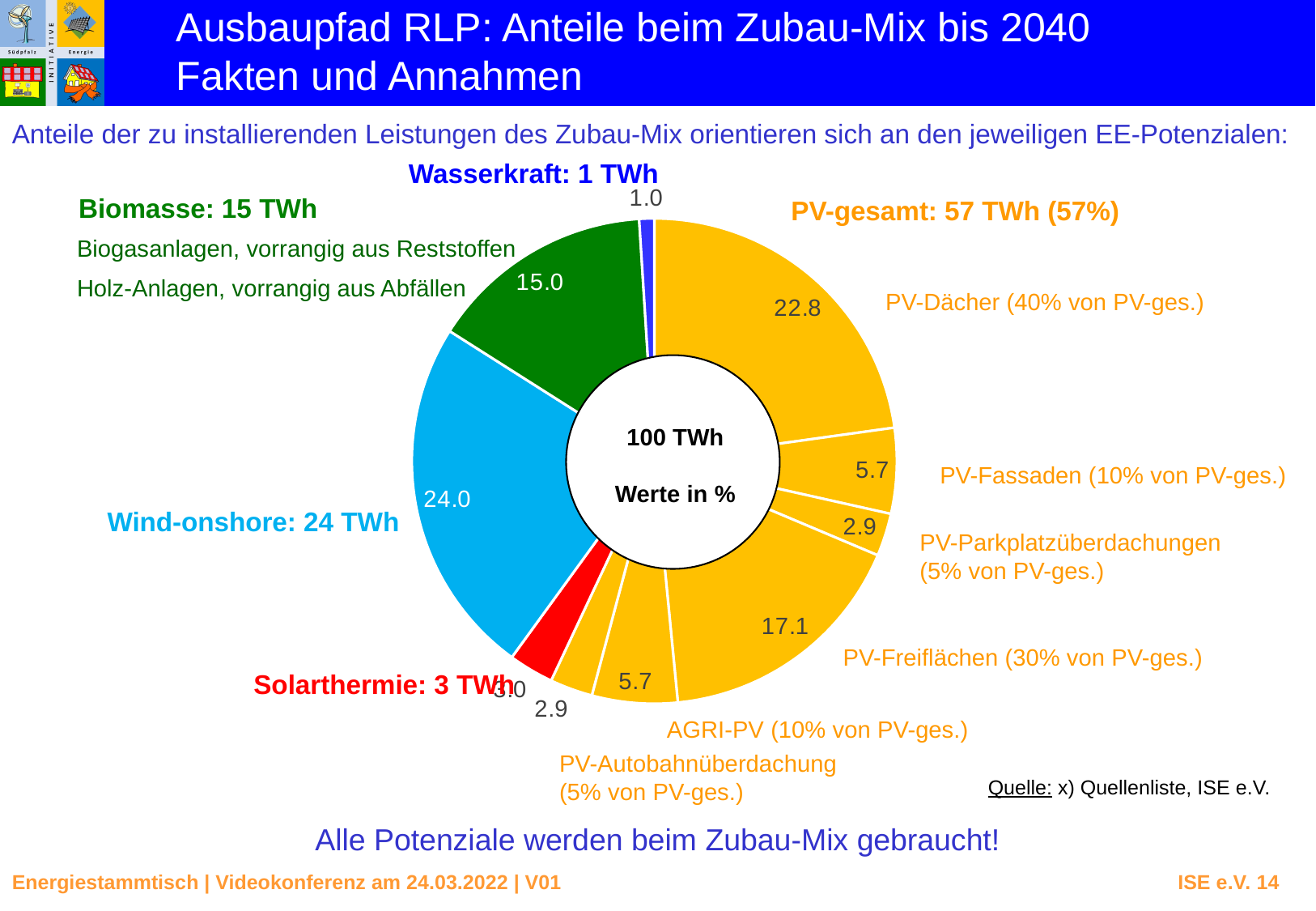
What is the value shown for the PV-Freiflächen segment? 17.1 Which segment has the smallest value in the chart? Wasserkraft What is the value shown for the Biomasse segment? 15.0 What is the value shown for the Wind-onshore segment? 24.0 How many segments does the chart have? 10 What total is written in the centre of the chart? 100 TWh What is the value shown for the PV-Dächer segment? 22.8 What is the difference between the Wind-onshore value and the Biomasse value? 9.0 Which segment has the largest value in the chart? Wind-onshore What kind of chart is shown on the slide? Doughnut (pie) chart What is the value shown for the Wasserkraft segment? 1.0 Which is larger, the PV-Dächer segment or the PV-Freiflächen segment? PV-Dächer